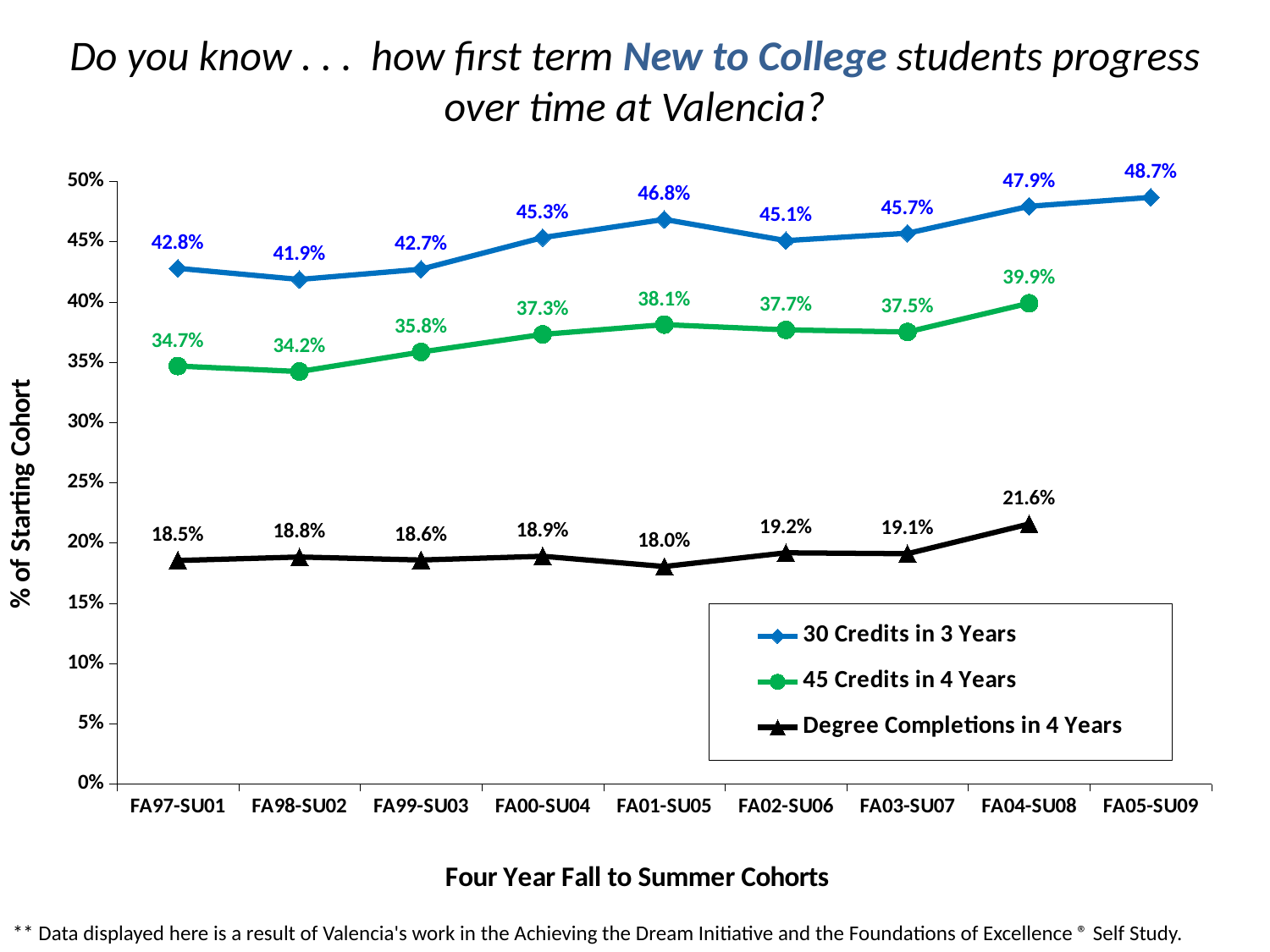
Which cohort has the highest value for 30 Credits in 3 Years? FA05-SU09 Is the 30 Credits in 3 Years value for FA00-SU04 greater or less than 45%? greater How many series does the legend list? 3 What is the value for Degree Completions in 4 Years for the FA04-SU08 cohort? 21.6% What is the value for 45 Credits in 4 Years for the FA99-SU03 cohort? 35.8% Which cohort has the lowest value for Degree Completions in 4 Years? FA01-SU05 How many cohorts are shown on the x axis? 9 What is the value for 30 Credits in 3 Years for the FA01-SU05 cohort? 46.8% What kind of chart is shown on the slide? line chart Which is larger: the 45 Credits in 4 Years value for FA04-SU08 or for FA03-SU07? FA04-SU08 Which cohort has the lowest value for 45 Credits in 4 Years? FA98-SU02